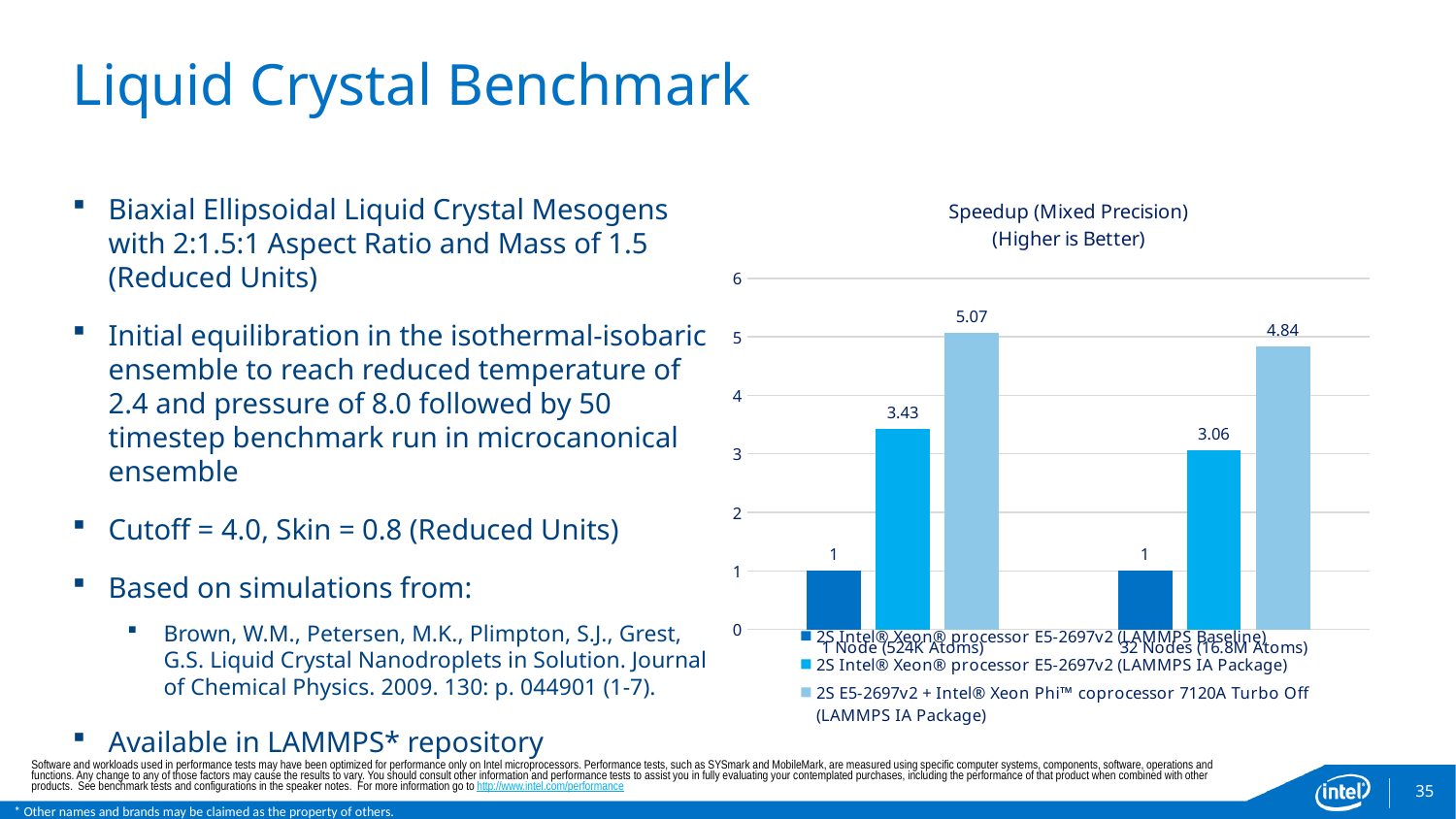
What is the speedup for the 2S E5-2697v2 + Intel Xeon Phi coprocessor 7120A Turbo Off (LAMMPS IA Package) series at 32 Nodes (16.8M Atoms)? 4.84 How many node configurations (categories) are shown on the x axis? 2 Which series has the lowest speedup at 32 Nodes (16.8M Atoms)? 2S Intel Xeon processor E5-2697v2 (LAMMPS Baseline) How many series does the legend list? 3 What is the speedup for the 2S E5-2697v2 + Intel Xeon Phi coprocessor 7120A Turbo Off (LAMMPS IA Package) series at 1 Node (524K Atoms)? 5.07 Which series has the highest speedup at 1 Node (524K Atoms)? 2S E5-2697v2 + Intel Xeon Phi coprocessor 7120A Turbo Off (LAMMPS IA Package) What is the difference between the Xeon Phi coprocessor speedup and the LAMMPS IA Package speedup at 1 Node (524K Atoms)? 1.64 What type of chart is shown on the slide? Bar chart What is the speedup for the 2S Intel Xeon processor E5-2697v2 (LAMMPS IA Package) series at 32 Nodes (16.8M Atoms)? 3.06 What is the speedup for the 2S Intel Xeon processor E5-2697v2 (LAMMPS Baseline) series at 1 Node (524K Atoms)? 1 Is the Xeon Phi coprocessor speedup at 32 Nodes (16.8M Atoms) greater or less than 4? greater Is the LAMMPS IA Package speedup larger at 1 Node (524K Atoms) or at 32 Nodes (16.8M Atoms)? 1 Node (524K Atoms)